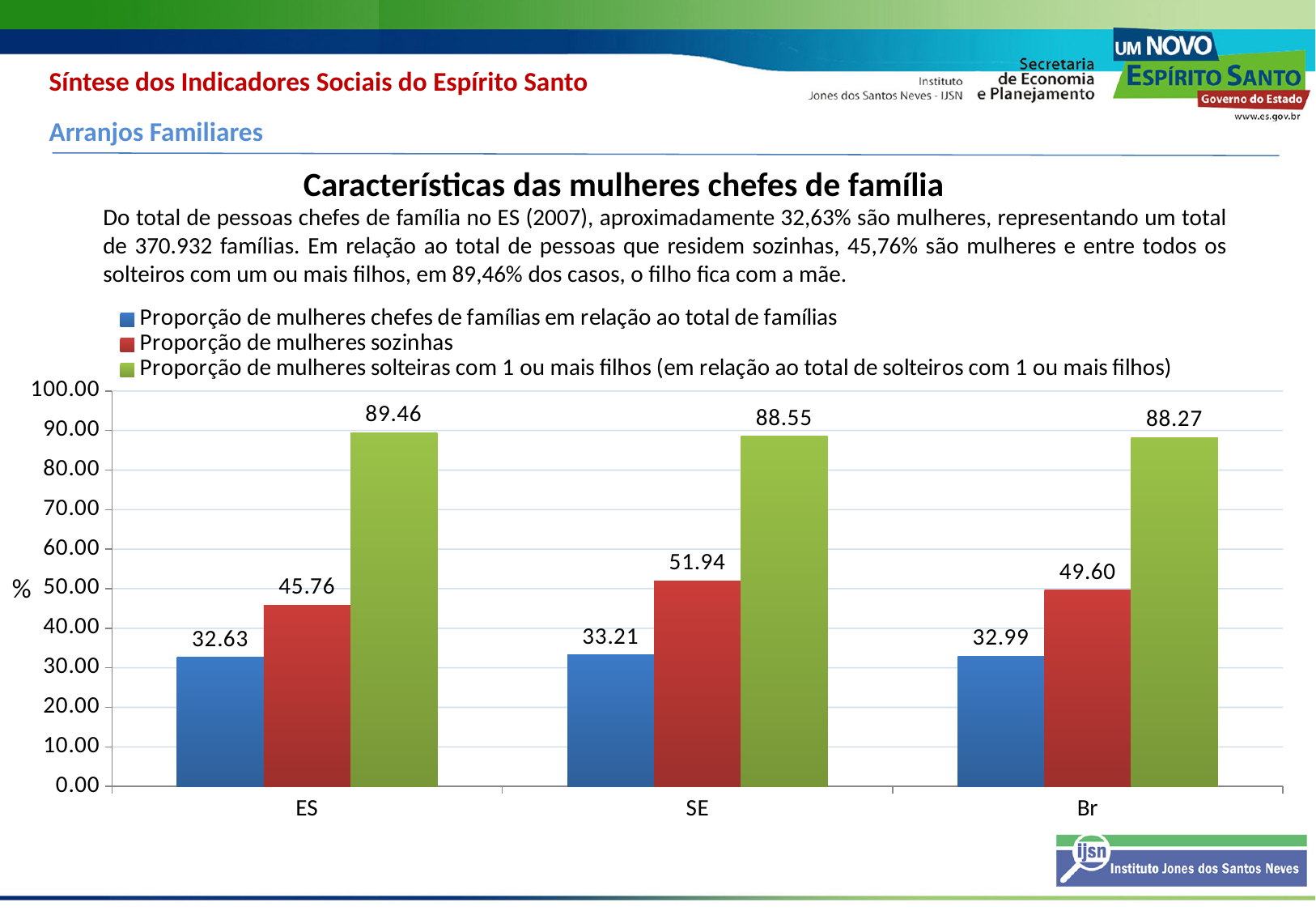
How many categories are shown on the x axis? 3 Which is larger: 'Proporção de mulheres sozinhas' for Br or for ES? Br Is the value of 'Proporção de mulheres chefes de famílias em relação ao total de famílias' for SE greater or less than 40.00? less What is the difference between the 'Proporção de mulheres sozinhas' values for SE and ES? 6.18 What is the value of 'Proporção de mulheres chefes de famílias em relação ao total de famílias' for Br? 32.99 What is the value of 'Proporção de mulheres solteiras com 1 ou mais filhos' for ES? 89.46 How many series does the legend list? 3 Which category has the highest value for 'Proporção de mulheres sozinhas'? SE Which category has the lowest value for 'Proporção de mulheres solteiras com 1 ou mais filhos'? Br What kind of chart is shown on the slide? bar chart What is the title of the chart? Características das mulheres chefes de família What is the value of 'Proporção de mulheres sozinhas' for SE? 51.94